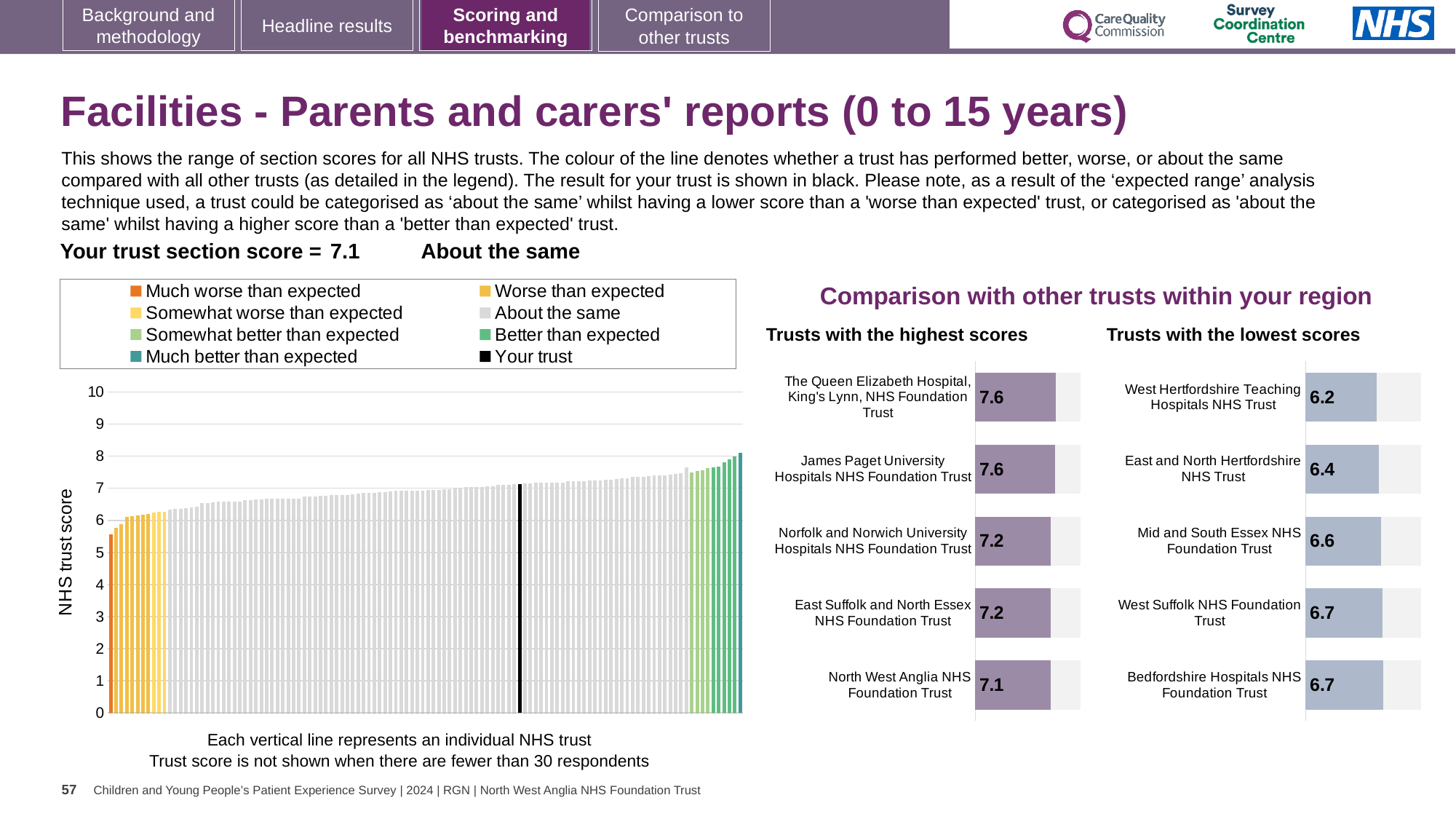
In the 'Trusts with the highest scores' chart, what is the score for The Queen Elizabeth Hospital, King's Lynn, NHS Foundation Trust? 7.6 In the 'Trusts with the lowest scores' chart, which trust has the lowest score? West Hertfordshire Teaching Hospitals NHS Trust In the 'Trusts with the highest scores' chart, what is the difference between the score for The Queen Elizabeth Hospital, King's Lynn, NHS Foundation Trust and the score for North West Anglia NHS Foundation Trust? 0.5 How many entries does the legend of the main chart on the left list? 8 In the main chart on the left showing all NHS trusts, is the value of the lowest (leftmost) bar greater or less than 6? less In the main chart on the left showing all NHS trusts, is the value of the highest (rightmost) bar greater or less than 7? greater In the 'Trusts with the lowest scores' chart, which has the higher score: East and North Hertfordshire NHS Trust or West Suffolk NHS Foundation Trust? West Suffolk NHS Foundation Trust How many trusts are listed in the 'Trusts with the highest scores' chart? 5 In the 'Trusts with the lowest scores' chart, what is the difference between the score for Mid and South Essex NHS Foundation Trust and the score for West Hertfordshire Teaching Hospitals NHS Trust? 0.4 In the 'Trusts with the lowest scores' chart, what is the score for West Hertfordshire Teaching Hospitals NHS Trust? 6.2 In the 'Trusts with the highest scores' chart, what is the score for North West Anglia NHS Foundation Trust? 7.1 What kind of chart is the main chart on the left showing all NHS trusts? bar chart